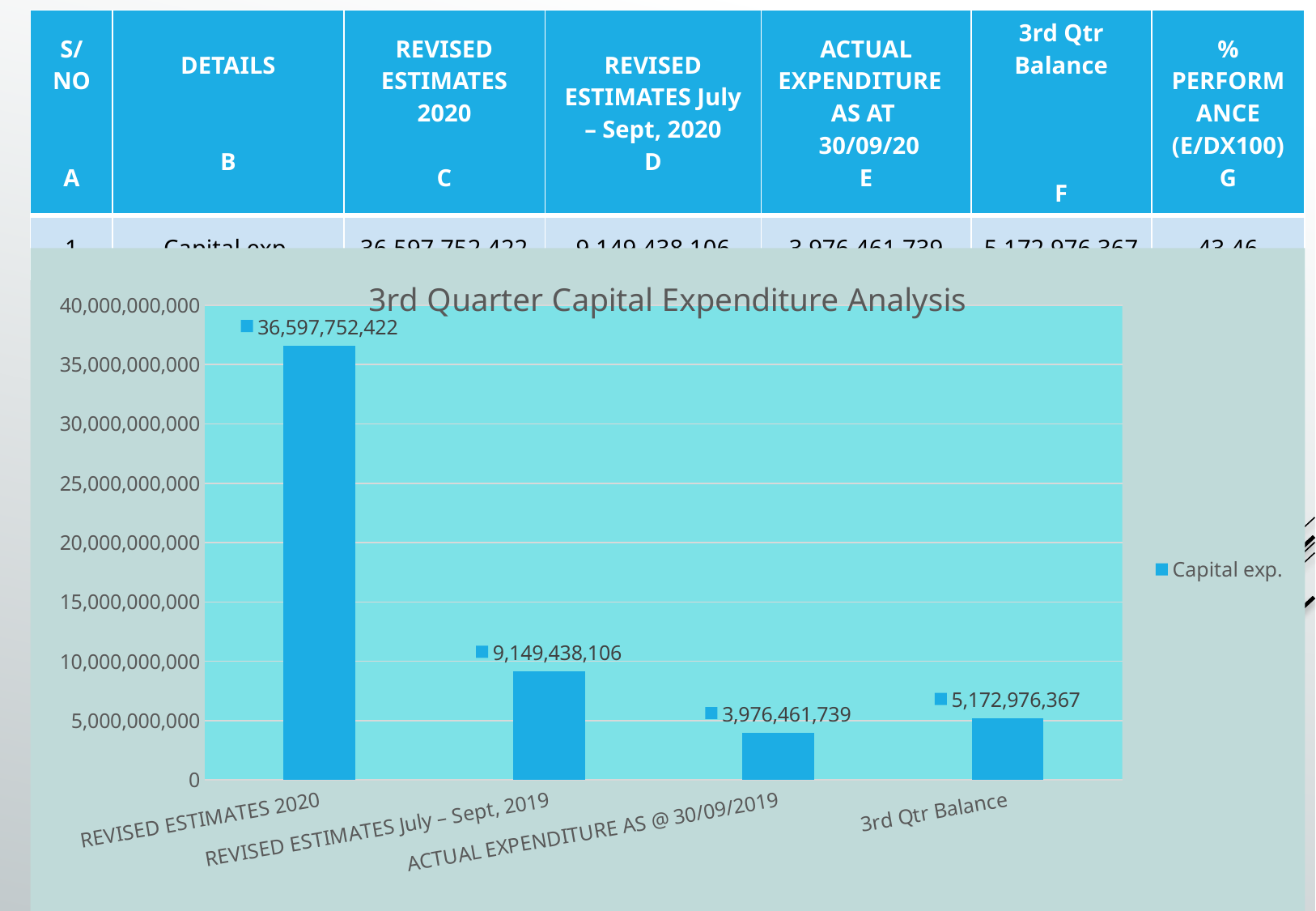
What is the value shown for 3rd Qtr Balance? 5,172,976,367 Which category has the highest value in the chart? REVISED ESTIMATES 2020 What is the value of the ACTUAL EXPENDITURE AS @ 30/09/2019 bar? 3,976,461,739 What is the difference between REVISED ESTIMATES July – Sept, 2019 and ACTUAL EXPENDITURE AS @ 30/09/2019? 5,172,976,367 Which is larger, the 3rd Qtr Balance or the ACTUAL EXPENDITURE AS @ 30/09/2019? 3rd Qtr Balance What is the difference between the 3rd Qtr Balance and ACTUAL EXPENDITURE AS @ 30/09/2019 values? 1,196,514,628 How many categories are plotted in the chart? 4 What is the value shown for REVISED ESTIMATES July – Sept, 2019? 9,149,438,106 What type of chart is shown on the slide? Bar chart What is the title of the chart? 3rd Quarter Capital Expenditure Analysis What is the value of the REVISED ESTIMATES 2020 bar? 36,597,752,422 Which category has the lowest value in the chart? ACTUAL EXPENDITURE AS @ 30/09/2019